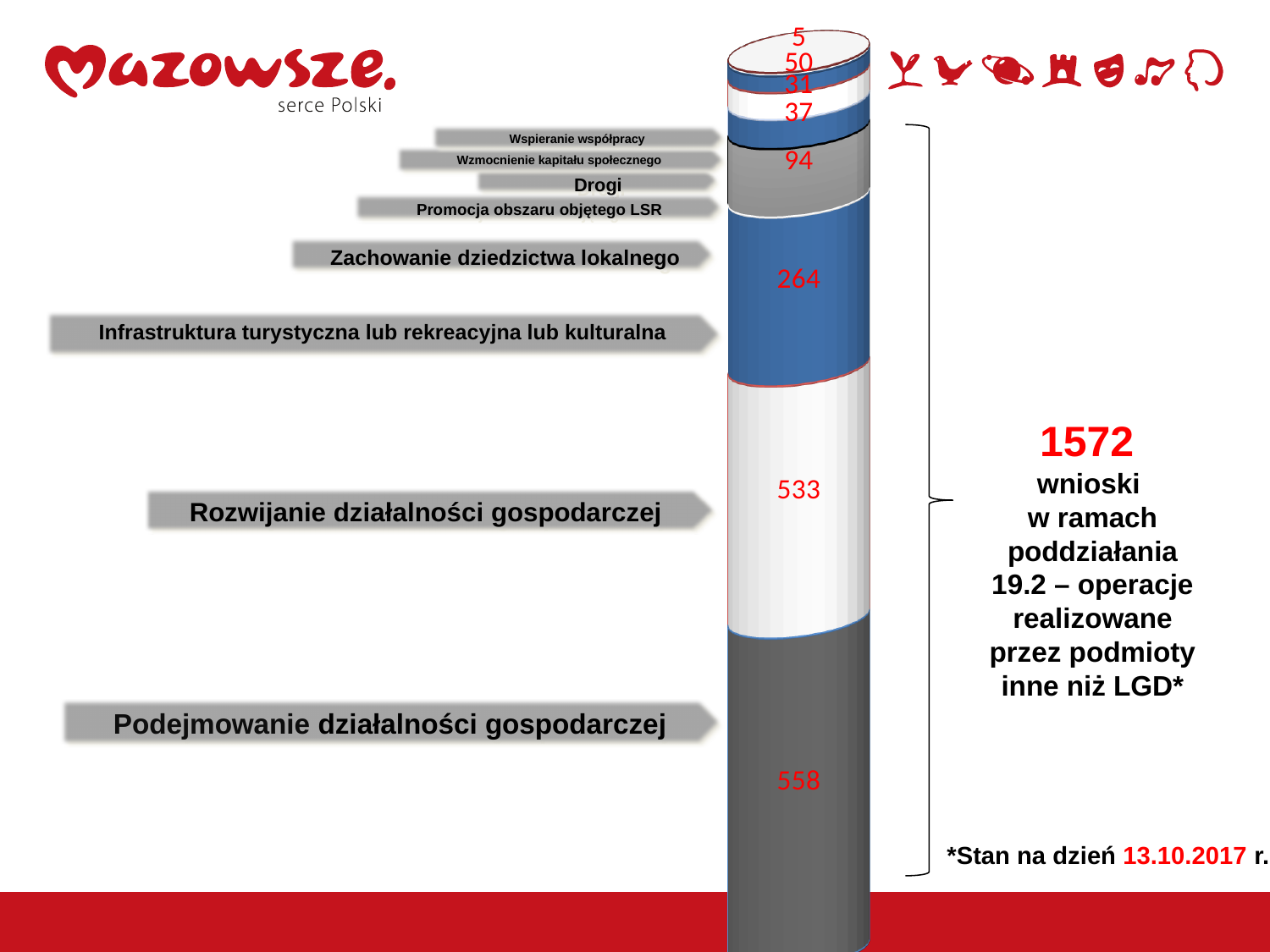
What value is shown for Wspieranie współpracy? 5 What is the difference between the values for Podejmowanie działalności gospodarczej and Rozwijanie działalności gospodarczej? 25 Which category has the largest value in the stacked bar? Podejmowanie działalności gospodarczej How many applications are shown for Podejmowanie działalności gospodarczej? 558 What value is shown for Infrastruktura turystyczna lub rekreacyjna lub kulturalna? 264 What value is shown for Rozwijanie działalności gospodarczej? 533 Which is larger: the value for Wzmocnienie kapitału społecznego or the value for Promocja obszaru objętego LSR? Wzmocnienie kapitału społecznego Which category has the smallest value in the stacked bar? Wspieranie współpracy What value is shown for Zachowanie dziedzictwa lokalnego? 94 What kind of chart is shown on the slide? Stacked bar chart What is the total of all segments in the stacked bar? 1572 How many categories (segments) make up the stacked bar? 8